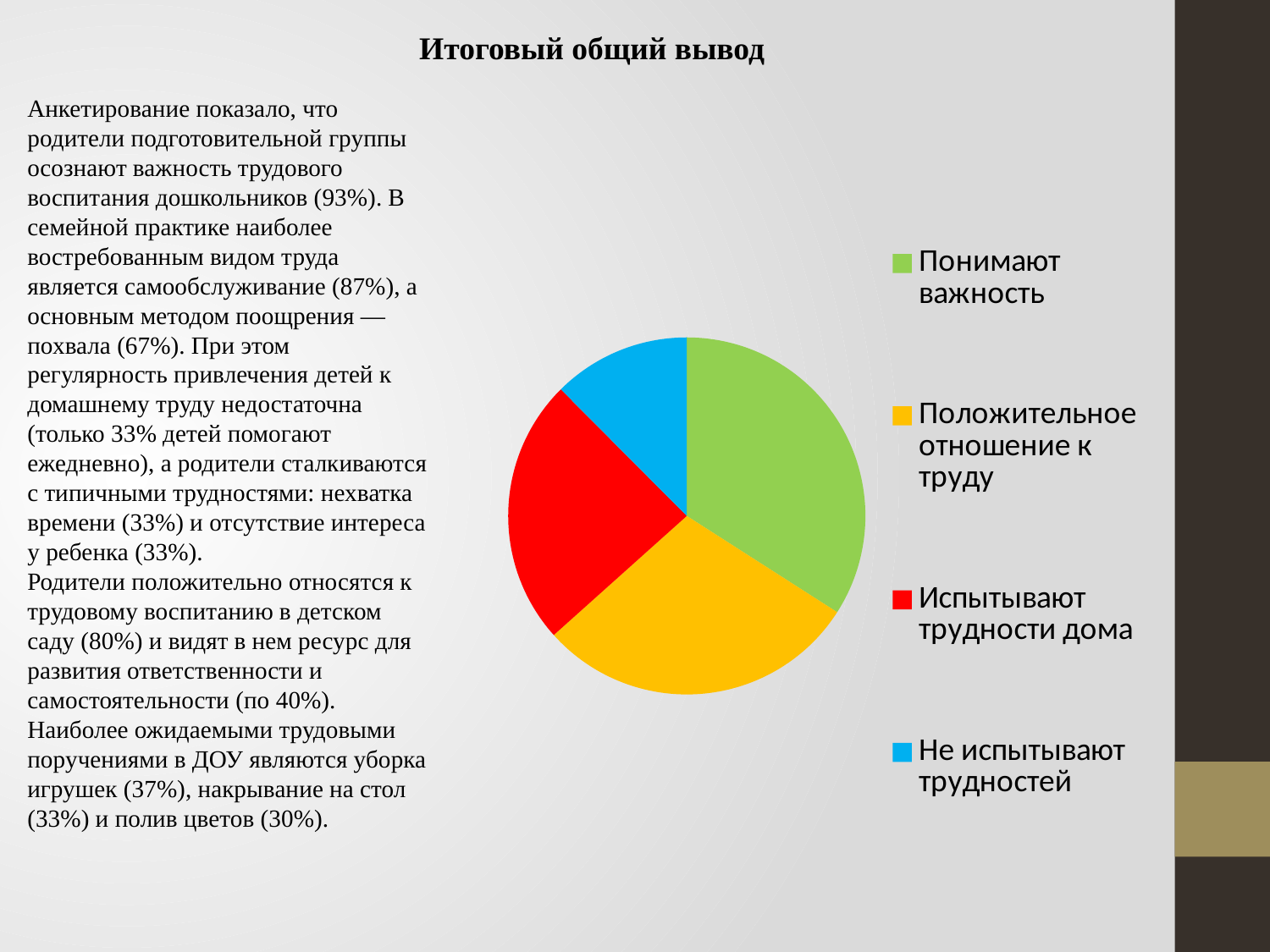
Which slice is larger: "Понимают важность" or "Испытывают трудности дома"? Понимают важность Which category has the smallest slice in the pie chart? Не испытывают трудностей Which legend entry is shown in green in the pie chart? Понимают важность Which slice is larger: "Понимают важность" or "Не испытывают трудностей"? Понимают важность How many slices does the pie chart have? 4 Which slice is larger: "Испытывают трудности дома" or "Не испытывают трудностей"? Испытывают трудности дома What colour is the slice for "Испытывают трудности дома" in the pie chart? red How many entries does the legend of the pie chart list? 4 What kind of chart is shown on the slide? pie chart